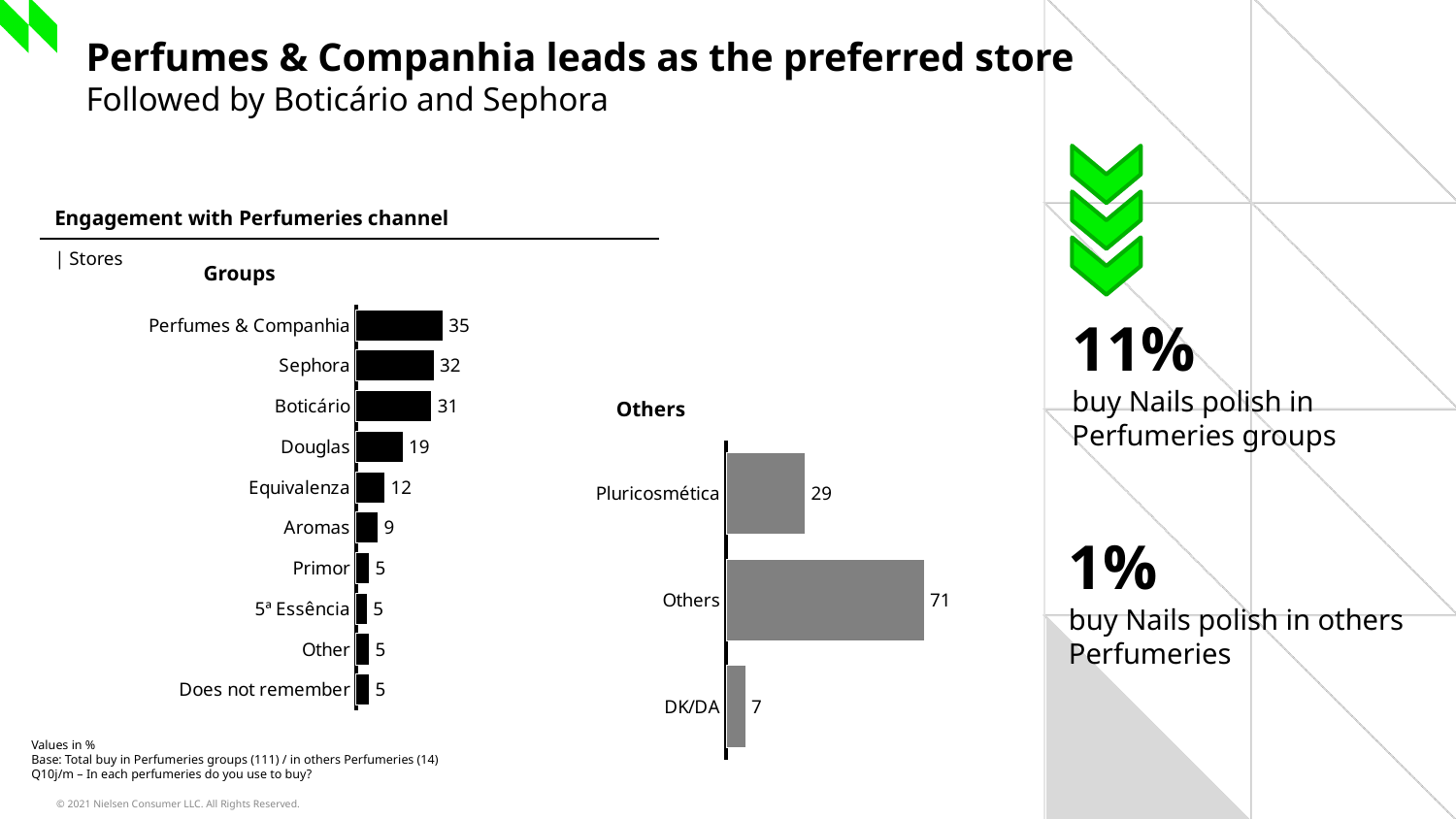
How many categories are shown in the Others chart? 3 In the Groups chart, what is the difference between Sephora and Equivalenza? 20 In the Groups chart, what is the value for Perfumes & Companhia? 35 In the Others chart, which category has the lowest value? DK/DA How many categories are shown in the Groups chart? 10 What type of chart is the Groups chart? Bar chart In the Others chart, what is the value for Pluricosmética? 29 In the Groups chart, which is larger, Boticário or Aromas? Boticário In the Groups chart, what is the value for Douglas? 19 In the Groups chart, which store has the highest value? Perfumes & Companhia In the Others chart, what is the difference between Others and Pluricosmética? 42 In the Others chart, which category has the highest value? Others